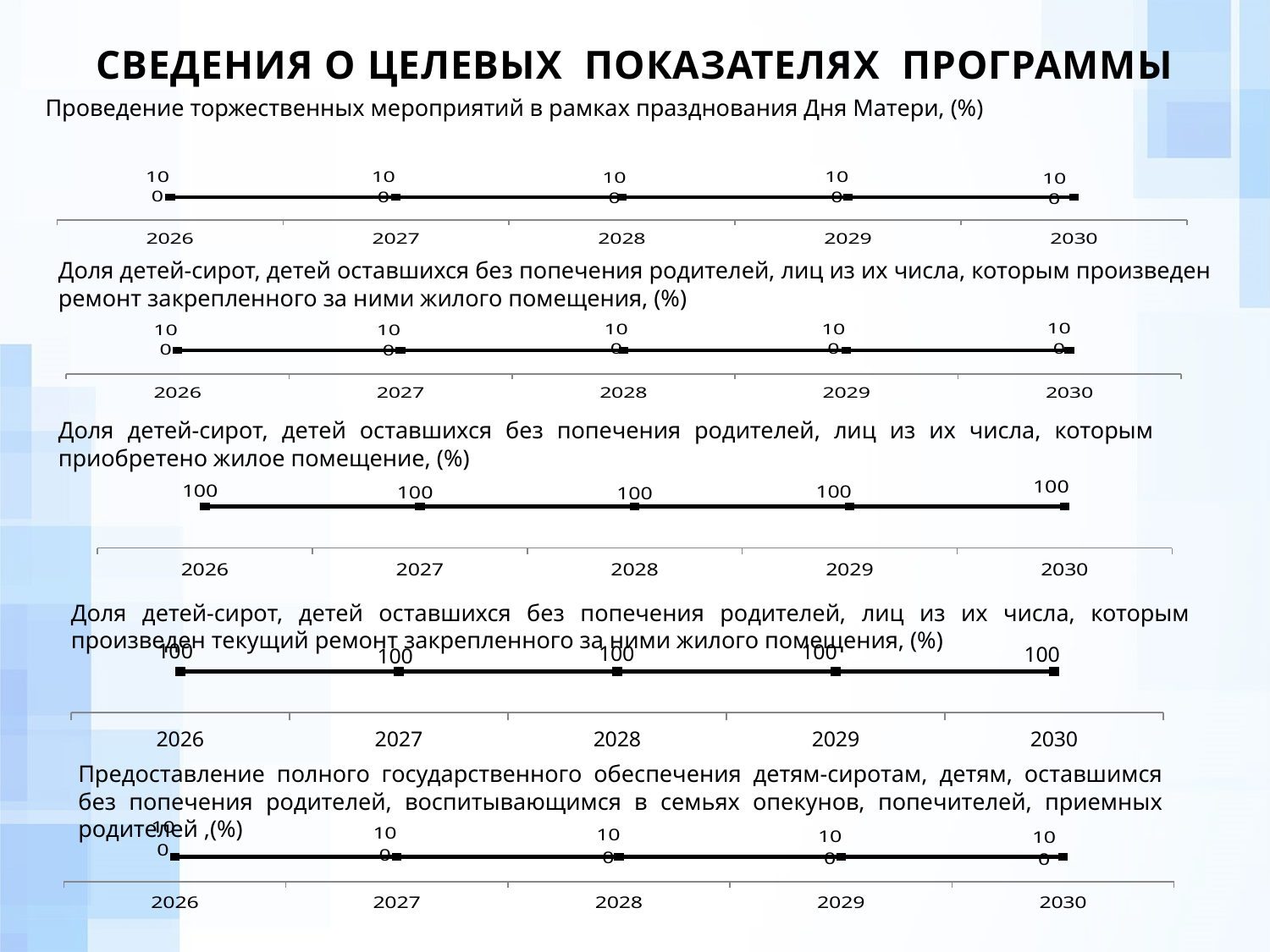
In the chart titled 'Доля детей-сирот, детей оставшихся без попечения родителей, лиц из их числа, которым произведен текущий ремонт закрепленного за ними жилого помещения, (%)', what is the value for 2028? 100 In the chart titled 'Доля детей-сирот, детей оставшихся без попечения родителей, лиц из их числа, которым произведен текущий ремонт закрепленного за ними жилого помещения, (%)', what is the difference between the values for 2026 and 2030? 0 In the chart titled 'Проведение торжественных мероприятий в рамках празднования Дня Матери, (%)', how many years are shown on the x axis? 5 In the chart titled 'Доля детей-сирот, детей оставшихся без попечения родителей, лиц из их числа, которым приобретено жилое помещение, (%)', what is the value for 2026? 100 In the chart titled 'Доля детей-сирот, детей оставшихся без попечения родителей, лиц из их числа, которым приобретено жилое помещение, (%)', what is the value for 2030? 100 How many charts are on the slide? 5 What kind of chart is the chart titled 'Проведение торжественных мероприятий в рамках празднования Дня Матери, (%)'? line chart In the chart titled 'Доля детей-сирот, детей оставшихся без попечения родителей, лиц из их числа, которым приобретено жилое помещение, (%)', do the values rise, fall or stay flat from 2026 to 2030? stay flat In the bottom chart on the slide, do the values rise, fall or stay flat from 2026 to 2030? stay flat In the chart titled 'Доля детей-сирот, детей оставшихся без попечения родителей, лиц из их числа, которым приобретено жилое помещение, (%)', how many data points are plotted? 5 In the chart titled 'Доля детей-сирот, детей оставшихся без попечения родителей, лиц из их числа, которым произведен текущий ремонт закрепленного за ними жилого помещения, (%)', what is the first year shown on the x axis? 2026